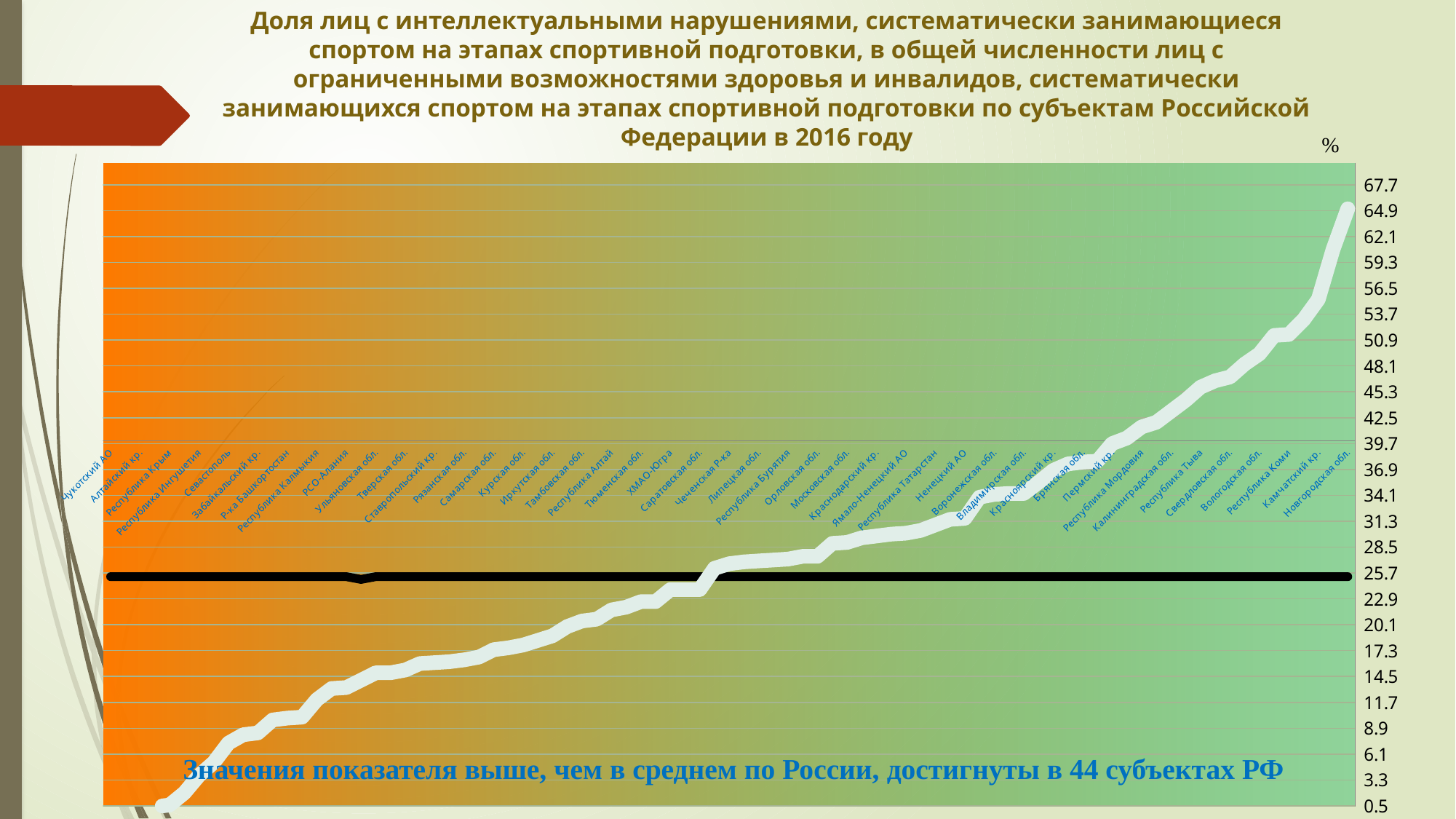
Which has the larger value, Республика Коми or Севастополь? Республика Коми Do the values of the white line rise or fall from left to right along the x axis? rise Is the value for Новгородская обл. greater or less than 59.3? greater Is the value for Республика Мордовия greater or less than 36.9? greater Which has the larger value, Камчатский кр. or Алтайский кр.? Камчатский кр. Is the value for Чукотский АО greater or less than 3.3? less Which region has the highest value on the chart? Новгородская обл. According to the text on the slide, in how many subjects of the Russian Federation is the indicator above the Russian average? 44 What kind of chart is shown on the slide? line chart